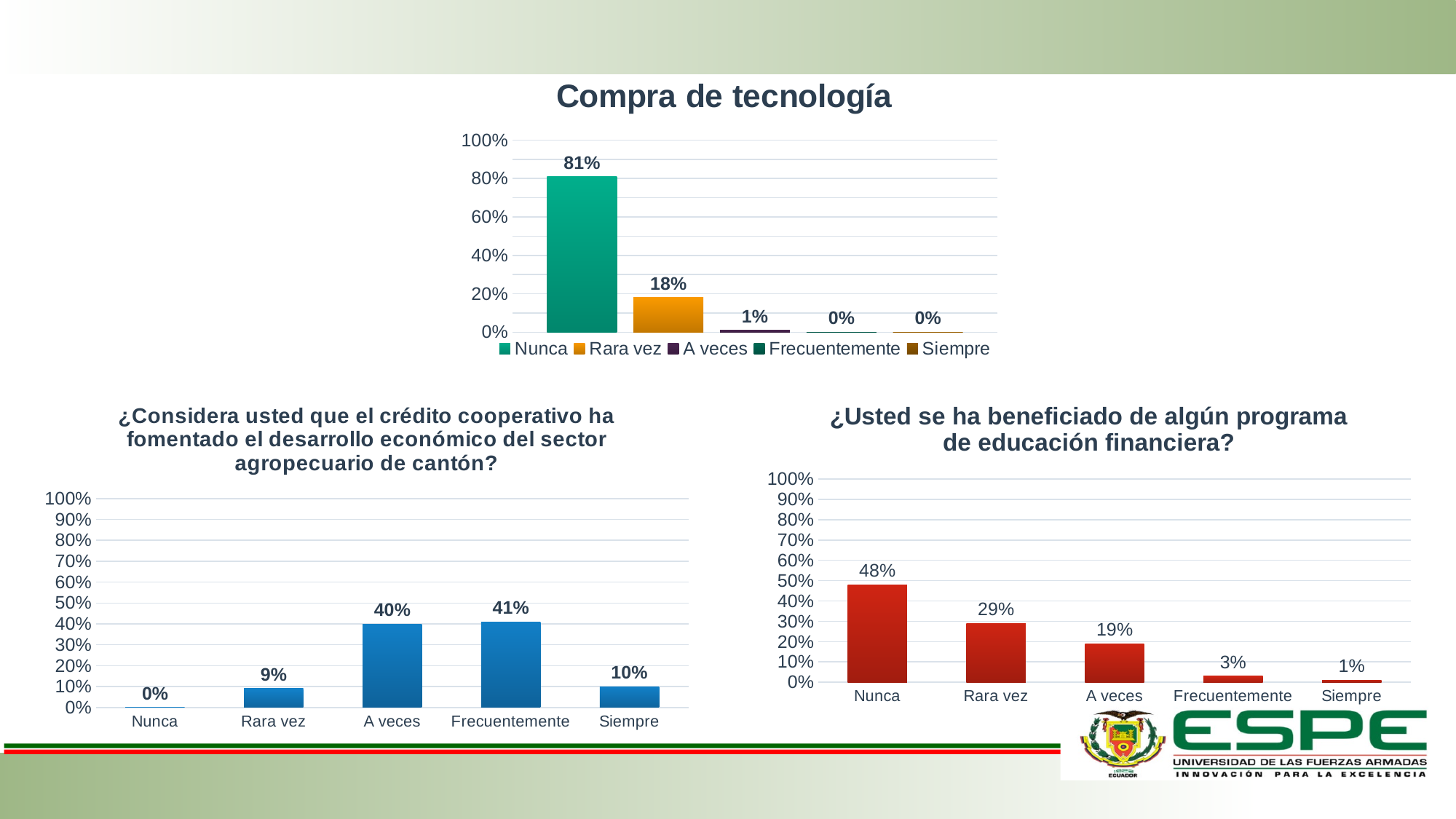
In the 'Compra de tecnología' chart, how many entries does the legend list? 5 In the chart titled '¿Usted se ha beneficiado de algún programa de educación financiera?', which category has the lowest value? Siempre In the 'Compra de tecnología' chart, what is the difference between Nunca and Rara vez? 63% In the chart titled '¿Considera usted que el crédito cooperativo ha fomentado el desarrollo económico del sector agropecuario de cantón?', what is the difference between Frecuentemente and Rara vez? 32% In the 'Compra de tecnología' chart, what is the value for Rara vez? 18% In the chart titled '¿Considera usted que el crédito cooperativo ha fomentado el desarrollo económico del sector agropecuario de cantón?', what is the value for A veces? 40% What kind of chart is the one titled '¿Usted se ha beneficiado de algún programa de educación financiera?'? bar chart In the chart titled '¿Usted se ha beneficiado de algún programa de educación financiera?', do the values rise or fall from Nunca to Siempre? fall In the 'Compra de tecnología' chart, what is the value for Nunca? 81% In the chart titled '¿Usted se ha beneficiado de algún programa de educación financiera?', what is the value for Nunca? 48% In the 'Compra de tecnología' chart, which category has the highest value? Nunca In the chart titled '¿Considera usted que el crédito cooperativo ha fomentado el desarrollo económico del sector agropecuario de cantón?', what is the value for Siempre? 10%